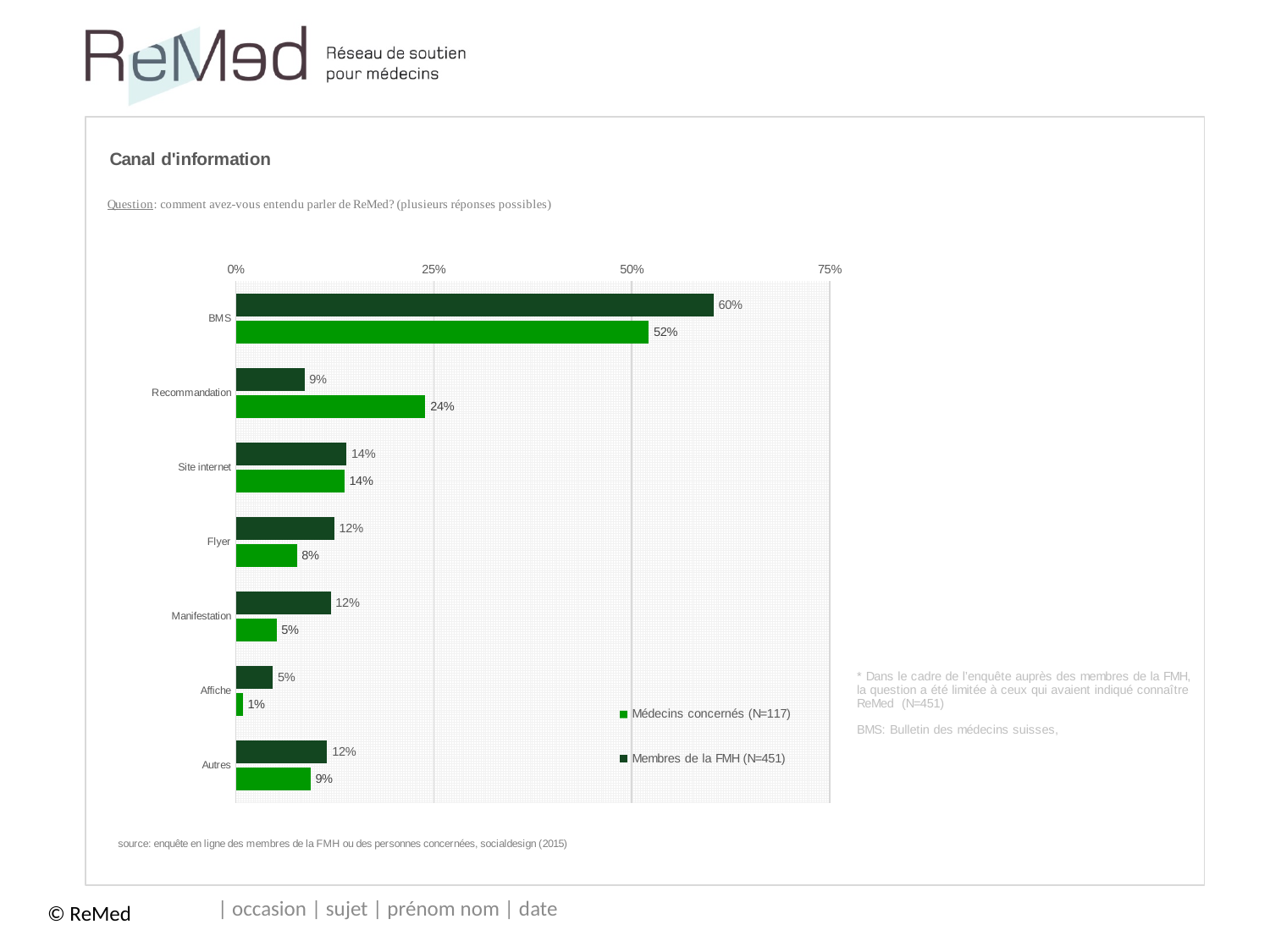
Is the value for BMS for Membres de la FMH (N=451) greater or less than 50%? greater What is the value for Recommandation for Médecins concernés (N=117)? 24% What is the value for BMS for Membres de la FMH (N=451)? 60% What is the title of the chart? Canal d'information What kind of chart is shown on the slide? bar chart For Recommandation, which series has the larger value: Médecins concernés (N=117) or Membres de la FMH (N=451)? Médecins concernés (N=117) What is the value for Affiche for Médecins concernés (N=117)? 1% What is the difference between the BMS values for Membres de la FMH (N=451) and Médecins concernés (N=117)? 8% How many categories are shown on the chart? 7 Which category has the highest value for Médecins concernés (N=117)? BMS How many series does the legend list? 2 Which category has the lowest value for Membres de la FMH (N=451)? Affiche